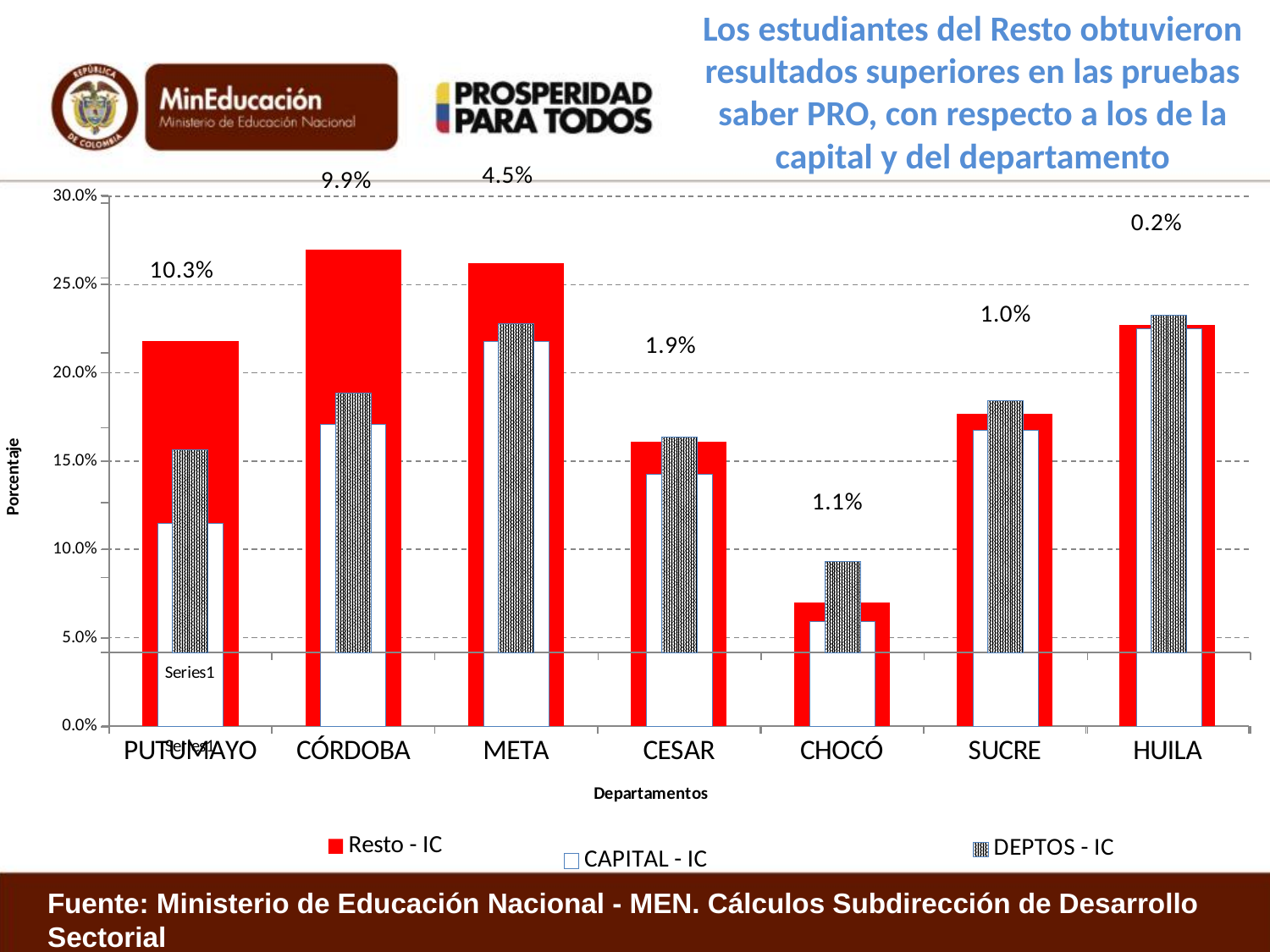
What data label is printed above the CHOCÓ group of bars? 1.1% What data label is printed above the PUTUMAYO group of bars? 10.3% How many departments are shown on the x axis of the chart? 7 In PUTUMAYO, which is larger: the CAPITAL - IC bar or the DEPTOS - IC bar? DEPTOS - IC How many series does the chart legend list? 3 What kind of chart is shown on the slide? bar chart Is the Resto - IC value for CÓRDOBA greater or less than 25.0%? greater Is the Resto - IC value for CHOCÓ greater or less than 10.0%? less Which department has the largest printed data label above its bars? PUTUMAYO What data label is printed above the HUILA group of bars? 0.2% What is the title of the vertical axis of the chart? Porcentaje Which department has the smallest Resto - IC bar? CHOCÓ